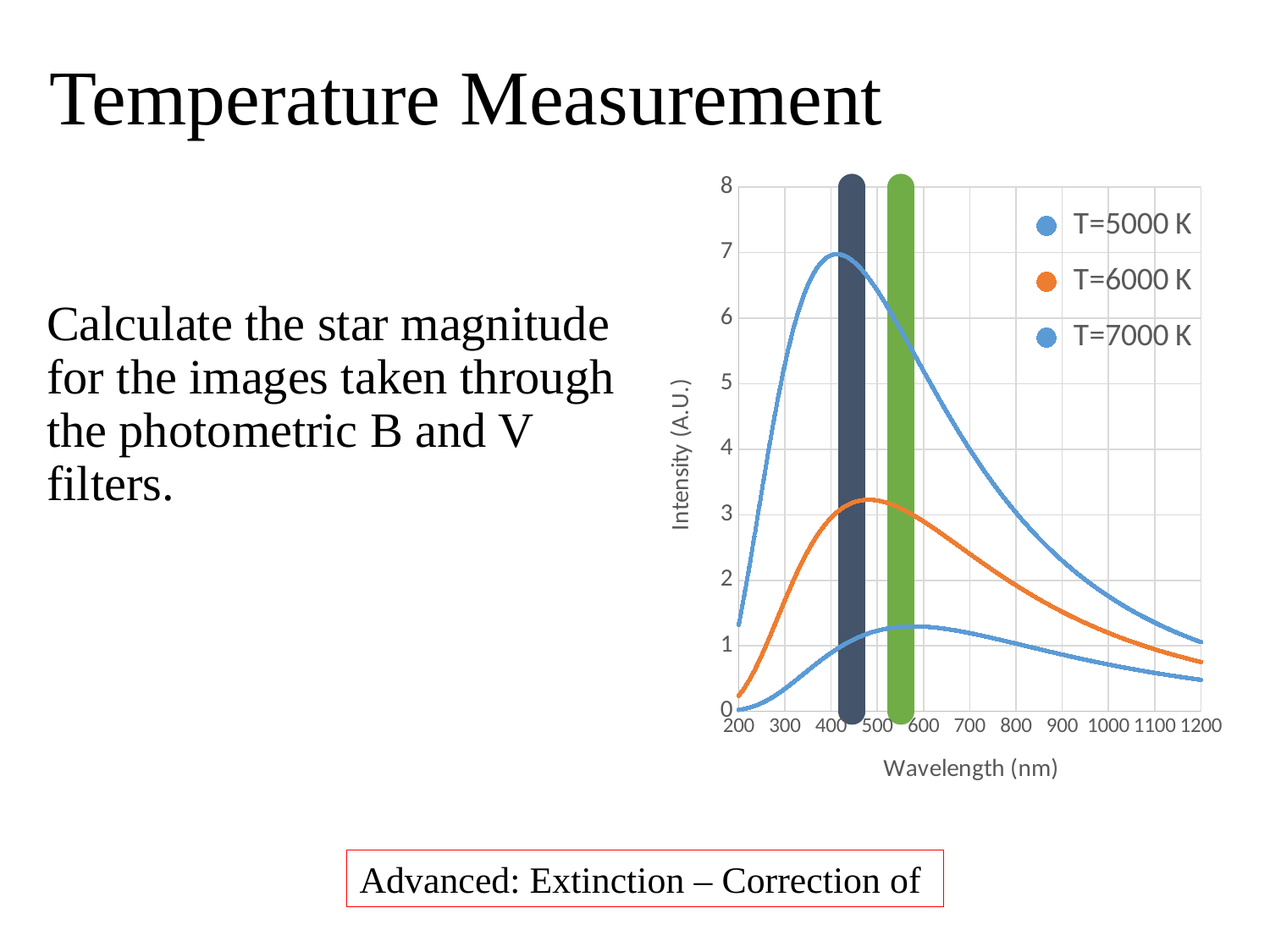
Is the value of the T=6000 K series at 1200 nm greater or less than 1? less How many series does the chart legend list? 3 What is the title of the y axis of the chart? Intensity (A.U.) What kind of chart is shown on the slide? line chart Does the peak of the T=6000 K series lie above or below 4 on the intensity axis? below What is the highest value labelled on the intensity axis? 8 Is the value of the T=6000 K series at 200 nm greater or less than 1? less What is the title of the x axis of the chart? Wavelength (nm) Between 600 nm and 1200 nm, does the T=6000 K series rise or fall? fall How many tick labels are shown on the wavelength axis? 11